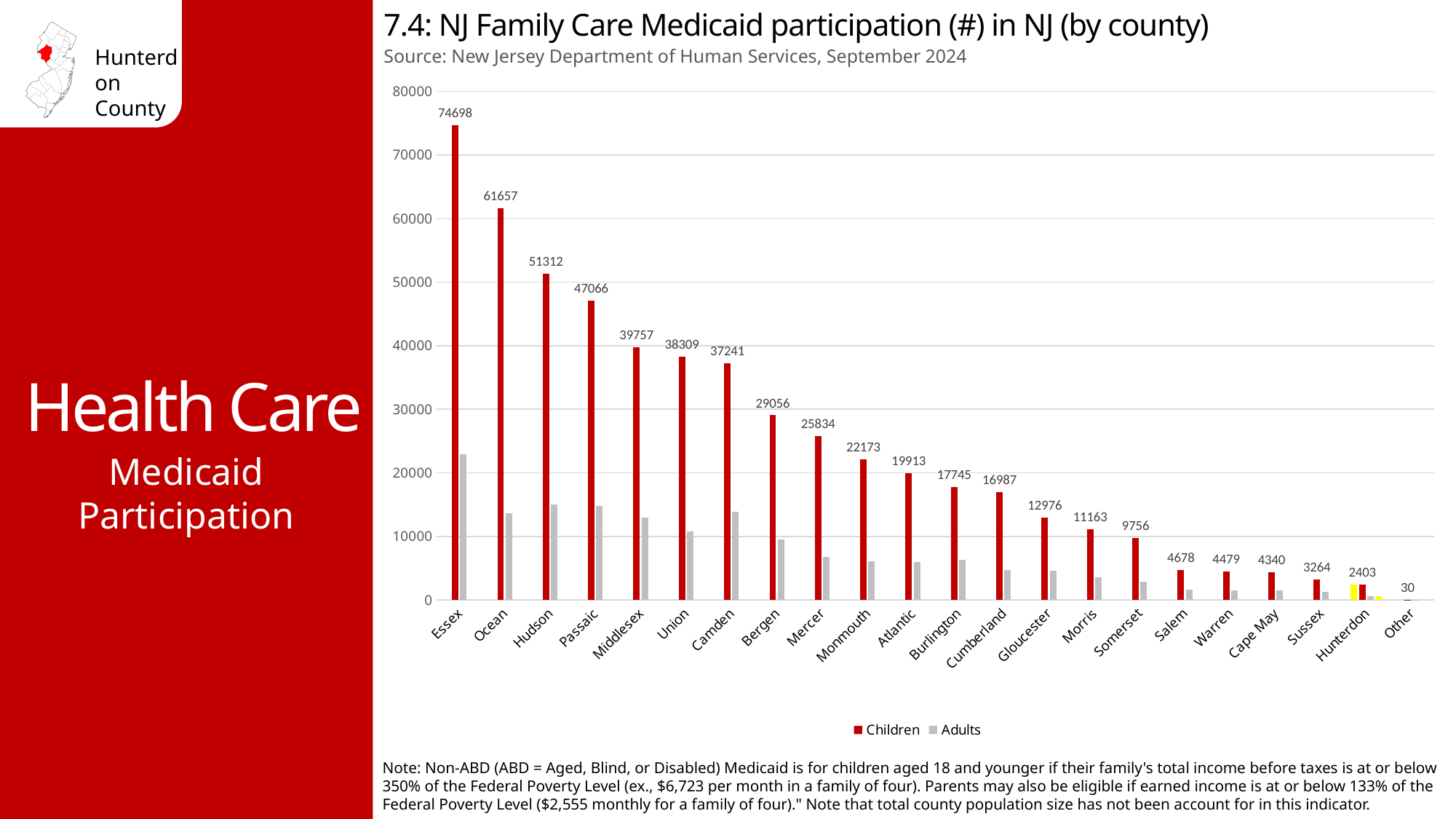
How many series does the legend list? 2 What is the difference between the Children values for Essex and Ocean? 13041 What kind of chart is shown? bar chart How many categories are shown on the x axis? 22 Which category has the highest Children value? Essex Is the Adults value for Ocean greater or less than 20000? less Which category has the lowest Children value? Other What is the difference between the Children values for Morris and Somerset? 1407 Which has a larger Children value, Hudson or Passaic? Hudson Is the Adults value for Essex greater or less than 20000? greater What is the Children value for Hunterdon? 2403 What is the Children value for Essex? 74698